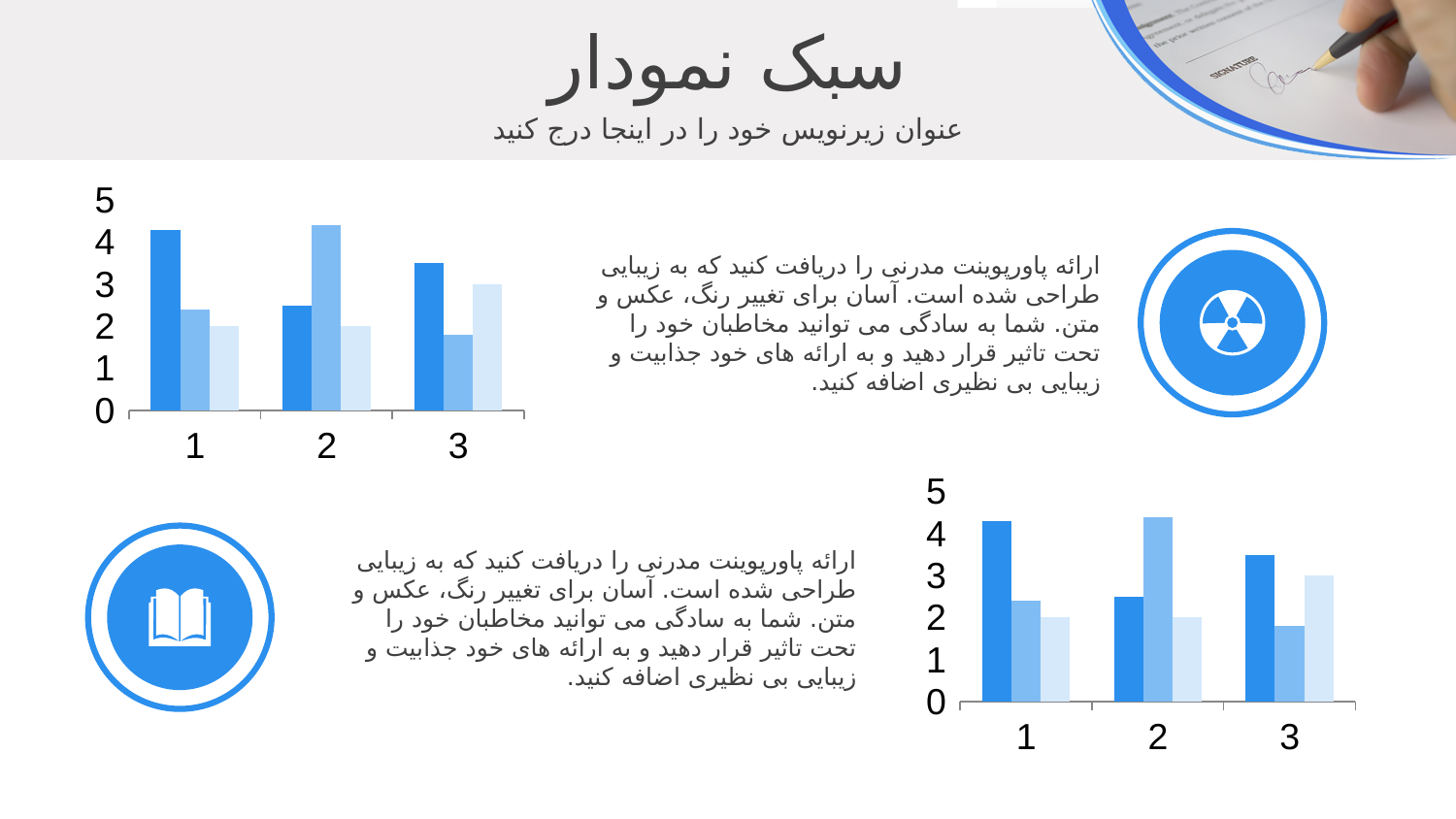
In the top-left chart, is the lightest blue bar for category 1 greater or less than 3? less In the bottom-right chart, is the medium blue bar for category 2 greater or less than 4? greater In the top-left chart, is the dark blue bar for category 1 greater or less than 4? greater In the bottom-right chart, which category has the tallest lightest blue bar? 3 In the bottom-right chart, is the dark blue bar larger for category 1 or category 2? category 1 In the top-left chart, which category has the shortest medium blue bar? 3 What is the highest tick value shown on the y axis of the bottom-right chart? 5 What kind of chart is the bottom-right chart? bar chart How many categories are shown on the x axis of the top-left chart? 3 In the top-left chart, which category has the tallest dark blue bar? 1 What kind of chart is the top-left chart? bar chart How many categories are shown on the x axis of the bottom-right chart? 3